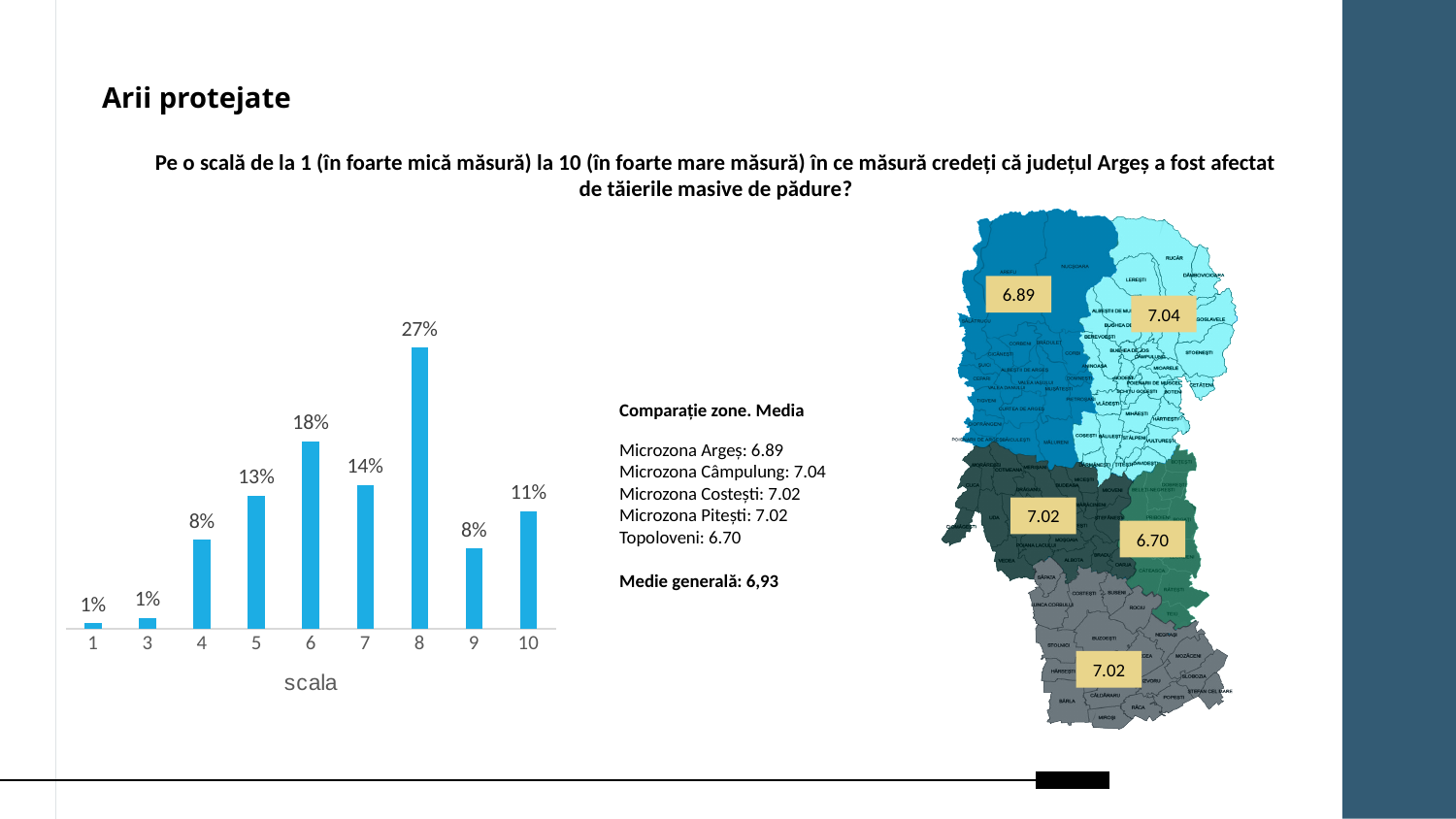
Which scale point has the highest percentage in the bar chart? 8 What is the value shown for scale point 6 in the bar chart? 18% What type of chart is shown on the left of the slide? bar chart What percentage of respondents chose 8 on the scale in the bar chart? 27% Which is larger in the bar chart: the value for scale point 5 or the value for scale point 10? 5 What is the value shown for scale point 10 in the bar chart? 11% Which scale point is missing from the x-axis of the bar chart between 1 and 10? 2 What is the difference between the values for scale points 8 and 6 in the bar chart? 9% How many bars are plotted in the bar chart? 9 Do the values in the bar chart rise or fall from scale point 8 to scale point 9? fall What is the difference between the values for scale points 7 and 5 in the bar chart? 1% What is the x-axis title of the bar chart? scala